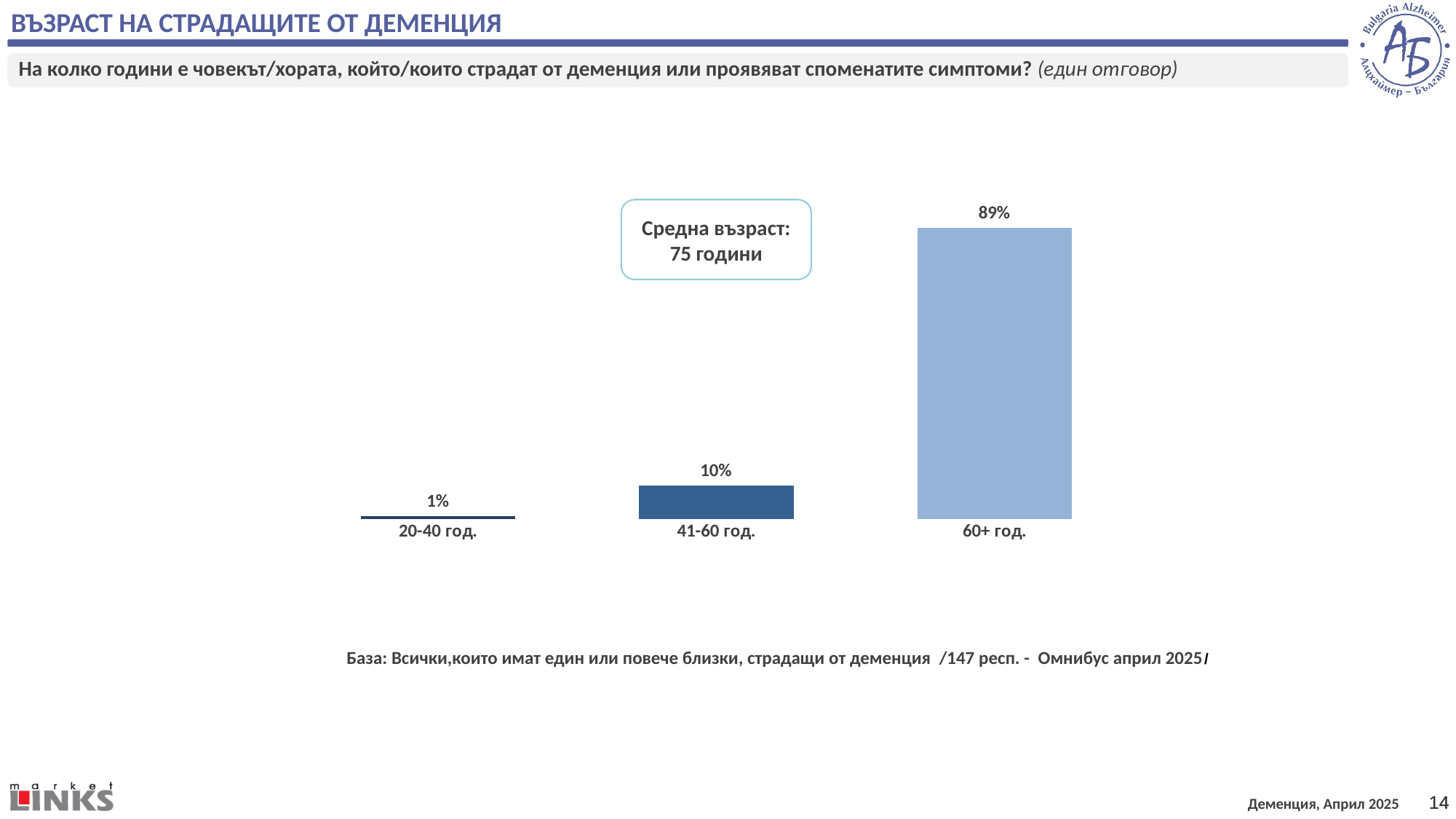
What average age is stated in the box on the chart? 75 години Do the values rise or fall from left to right across the age categories? Rise What kind of chart is shown on the slide? Bar chart What is the difference between the values for 60+ год. and 41-60 год.? 79% What is the value for the 60+ год. category? 89% How many age categories are shown in the chart? 3 Which age category has the highest value? 60+ год. What is the value for the 20-40 год. category? 1% What is the difference between the values for 41-60 год. and 20-40 год.? 9% What is the value for the 41-60 год. category? 10% Which age category has the lowest value? 20-40 год. Which is larger, the value for 41-60 год. or the value for 20-40 год.? 41-60 год.